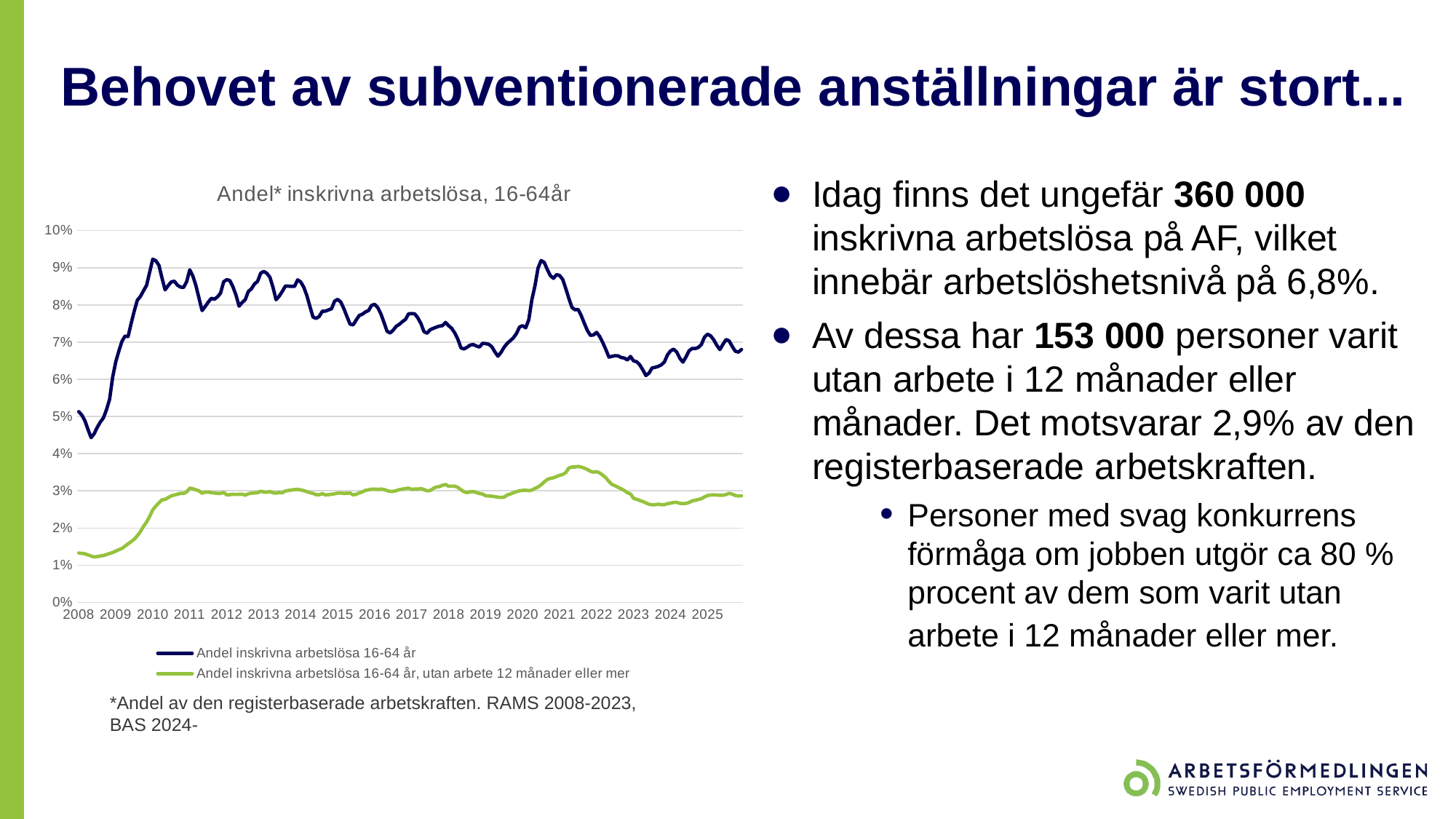
In 2020, which series has the higher value: 'Andel inskrivna arbetslösa 16-64 år' or 'Andel inskrivna arbetslösa 16-64 år, utan arbete 12 månader eller mer'? Andel inskrivna arbetslösa 16-64 år Is the value for 'Andel inskrivna arbetslösa 16-64 år, utan arbete 12 månader eller mer' in 2008 greater or less than 2%? less What kind of chart is shown on the slide? line chart Is the value for 'Andel inskrivna arbetslösa 16-64 år' at the start of 2008 greater or less than 6%? less Is the peak value for 'Andel inskrivna arbetslösa 16-64 år' around 2010 greater or less than 9%? greater How many years are labelled on the x axis of the chart? 18 How many series does the chart legend list? 2 Does the value for 'Andel inskrivna arbetslösa 16-64 år' rise or fall between 2008 and 2010? rise Which series is drawn in green in the chart? Andel inskrivna arbetslösa 16-64 år, utan arbete 12 månader eller mer What is the title of the chart? Andel* inskrivna arbetslösa, 16-64år